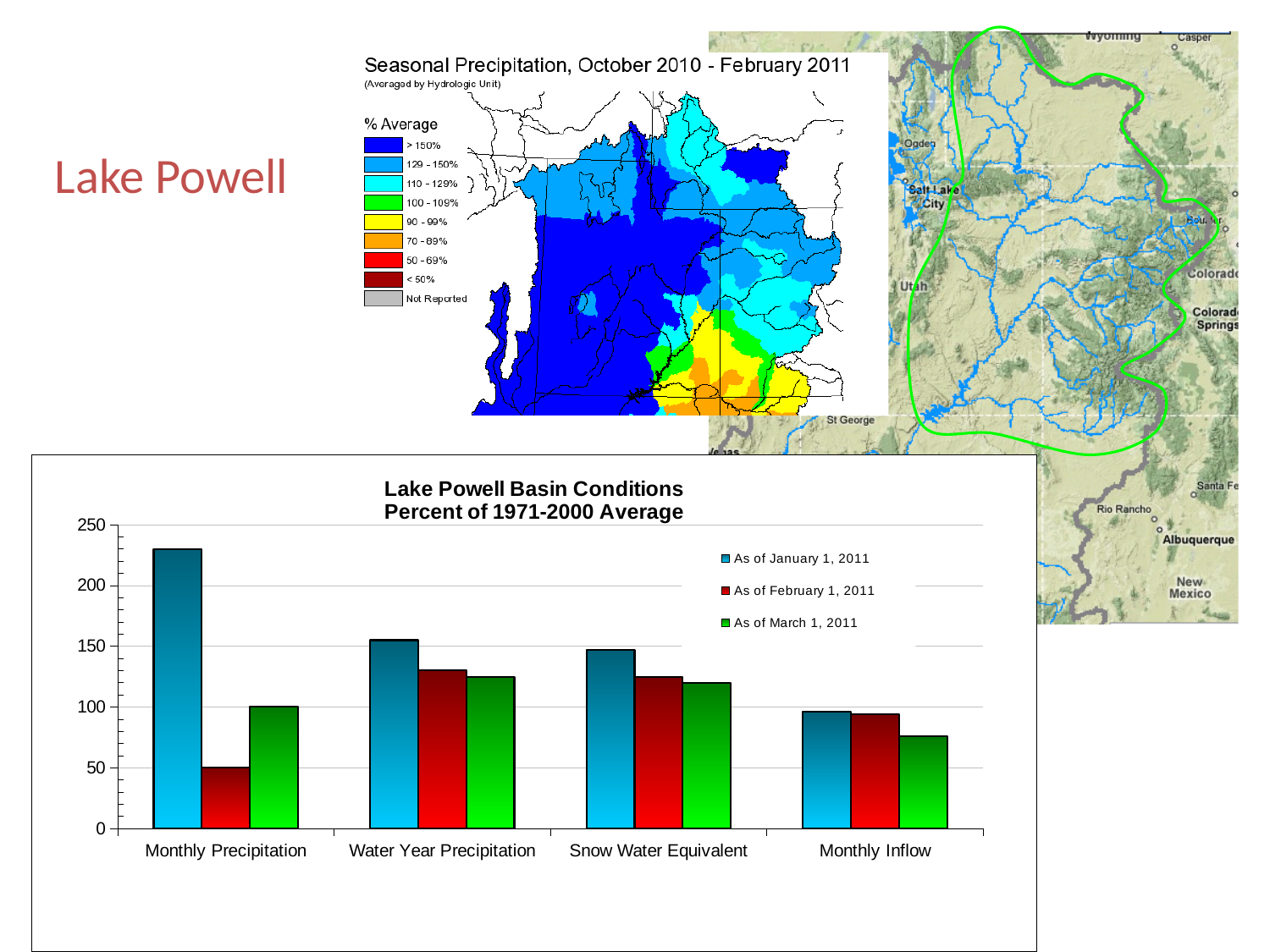
For Monthly Inflow, do the values rise or fall from As of January 1, 2011 to As of March 1, 2011? fall Which category has the highest bar in the Lake Powell Basin Conditions chart? Monthly Precipitation For the As of January 1, 2011 series, which is larger: Monthly Precipitation or Water Year Precipitation? Monthly Precipitation Is the As of February 1, 2011 value for Water Year Precipitation greater or less than 150? less How many categories are shown on the x axis of the Lake Powell Basin Conditions chart? 4 What kind of chart is shown on the slide? bar chart Is the As of March 1, 2011 value for Monthly Inflow greater or less than 100? less Which category has the lowest bar in the Lake Powell Basin Conditions chart? Monthly Precipitation What is the title of the bar chart on the slide? Lake Powell Basin Conditions Percent of 1971-2000 Average Is the As of January 1, 2011 value for Monthly Precipitation greater or less than 200? greater How many series does the legend of the Lake Powell Basin Conditions chart list? 3